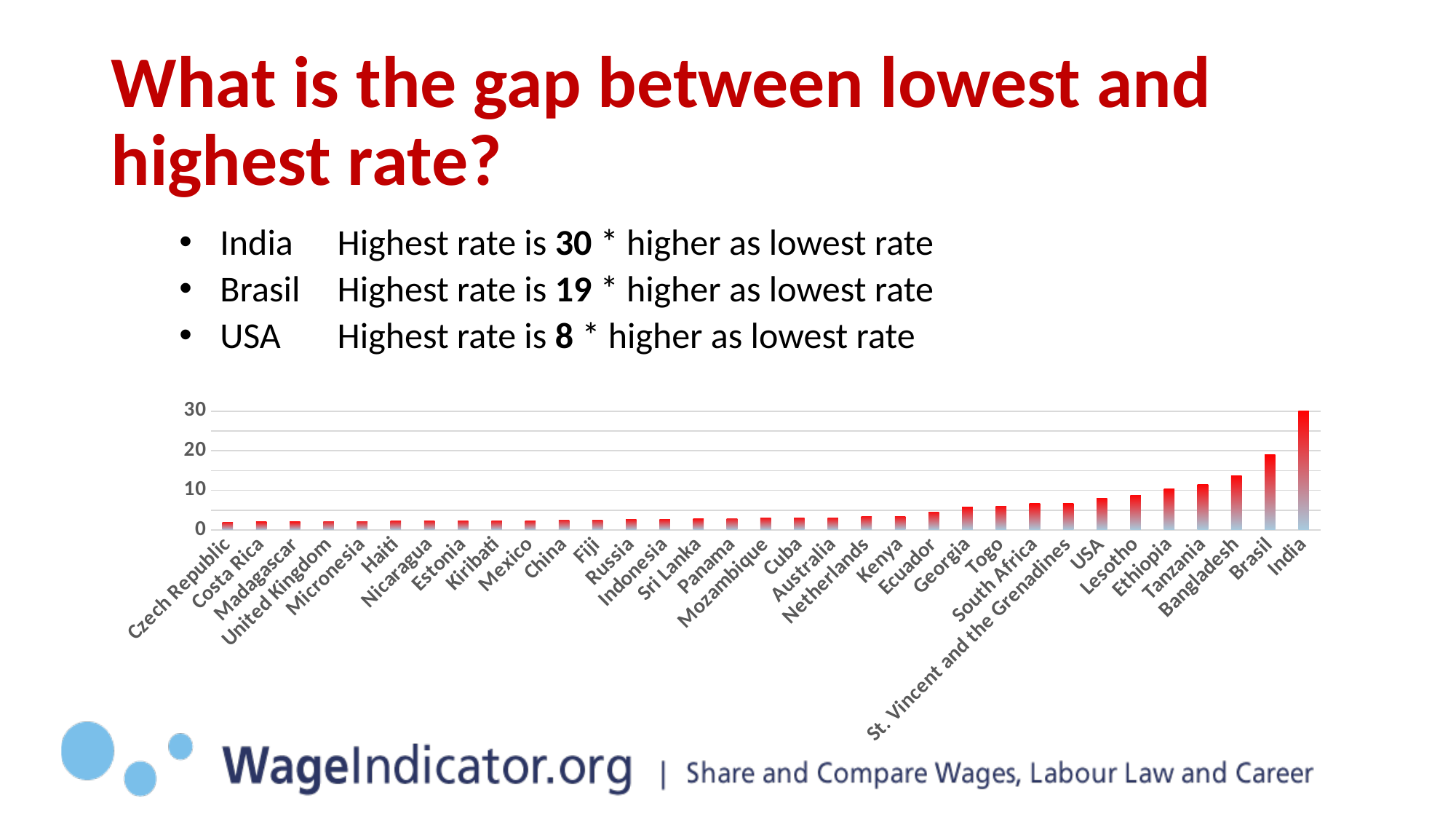
Which has the larger value, Brasil or Bangladesh? Brasil What kind of chart is shown on the slide? bar chart What is the value for Brasil in the chart? 19 Is the value for Bangladesh greater or less than 10? greater What is the difference between the values for India and Brasil? 11 How many countries are shown on the x axis of the chart? 33 What is the difference between the values for India and USA? 22 Do the bar values rise or fall from left to right along the x axis? rise What is the value for India in the chart? 30 What is the value for USA in the chart? 8 Is the value for Lesotho greater or less than 10? less Which country has the highest bar in the chart? India